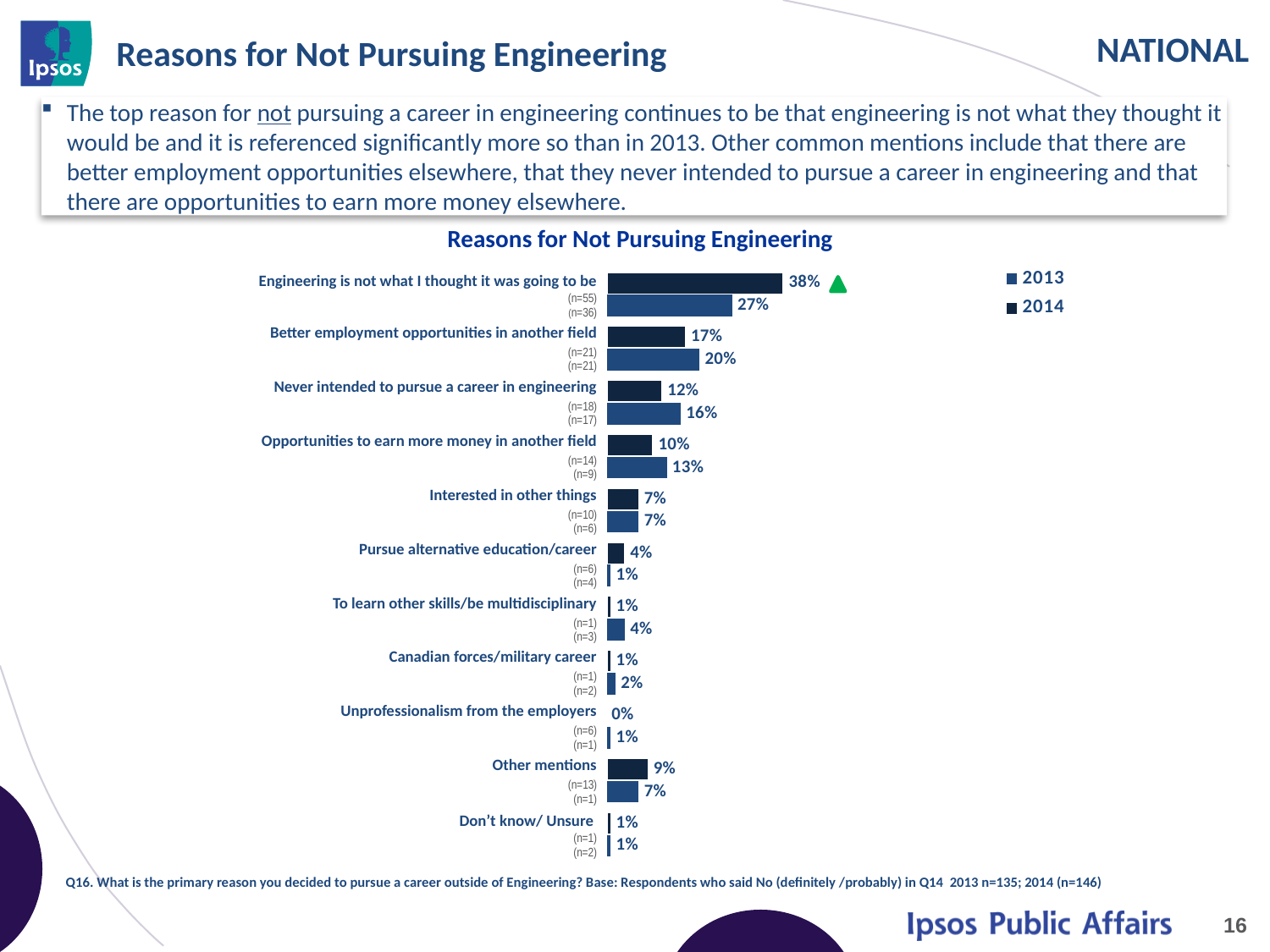
What is the title of the chart? Reasons for Not Pursuing Engineering How many series does the legend list? 2 What is the 2013 value for "Other mentions"? 7% Which reason has the highest 2014 value? Engineering is not what I thought it was going to be For "Opportunities to earn more money in another field", which year has the larger value, 2013 or 2014? 2013 Which reason has the lowest 2014 value? Unprofessionalism from the employers What is the difference between the 2014 and 2013 values for "Engineering is not what I thought it was going to be"? 11% What is the 2013 value for "Better employment opportunities in another field"? 20% What is the 2014 value for "Engineering is not what I thought it was going to be"? 38% How many reason categories are shown in the chart? 11 What is the 2014 value for "Never intended to pursue a career in engineering"? 12% What kind of chart is shown on the slide? Bar chart